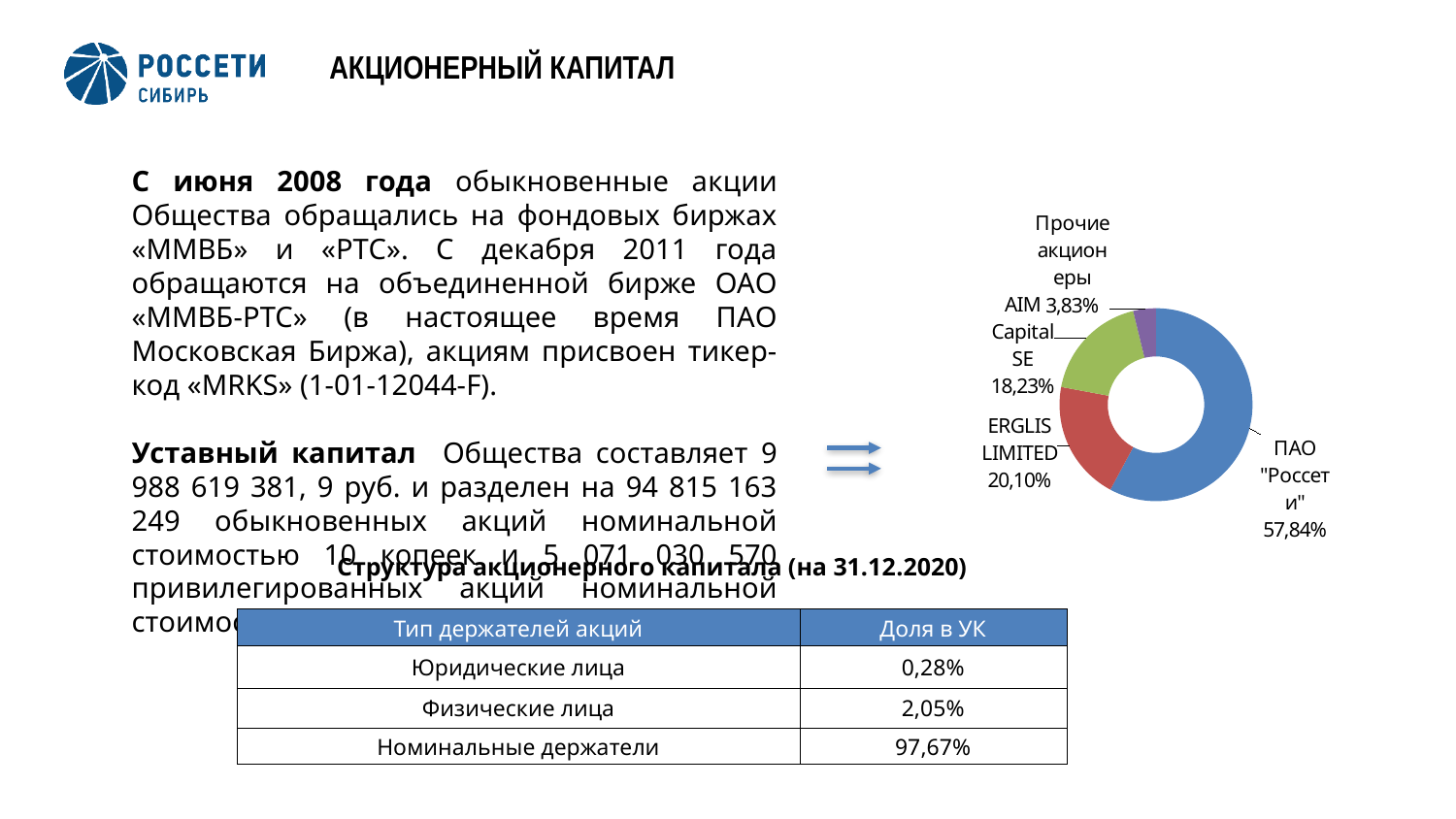
What share does AIM Capital SE hold in the doughnut chart? 18,23% What share of the share capital does ПАО "Россети" hold according to the doughnut chart? 57,84% What is the difference in percentage points between the shares of ERGLIS LIMITED and AIM Capital SE? 1,87 How many slices does the doughnut chart have? 4 Which holds a larger share: ERGLIS LIMITED or AIM Capital SE? ERGLIS LIMITED What colour is the slice for ПАО "Россети" in the doughnut chart? Blue Which shareholder has the largest slice in the doughnut chart? ПАО "Россети" What type of chart is used to show the share capital structure? Doughnut chart What share is shown for Прочие акционеры in the doughnut chart? 3,83% What share does ERGLIS LIMITED hold in the doughnut chart? 20,10% Which shareholder has the smallest slice in the doughnut chart? Прочие акционеры